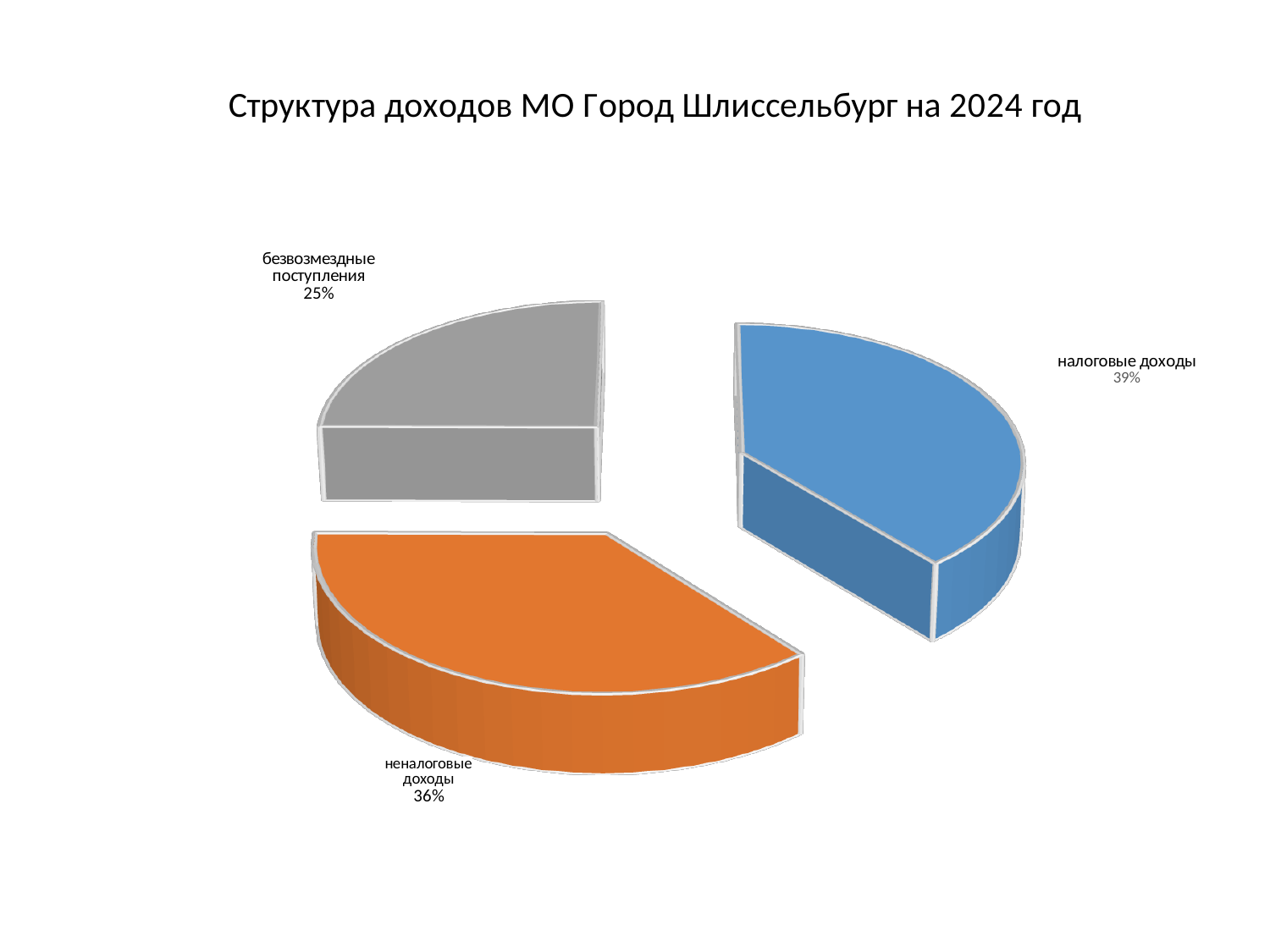
Which category has the largest share of the pie? налоговые доходы What is the difference in percentage points between налоговые доходы and неналоговые доходы? 3% Which is larger: the share for неналоговые доходы or the share for безвозмездные поступления? неналоговые доходы What colour is the slice for налоговые доходы? blue What is the title of the chart? Структура доходов МО Город Шлиссельбург на 2024 год What kind of chart is shown on the slide? pie chart What share of the pie does безвозмездные поступления represent? 25% What share of the pie does неналоговые доходы represent? 36% Which category has the smallest share of the pie? безвозмездные поступления How many categories are shown in the pie chart? 3 What share of the pie does налоговые доходы represent? 39% What is the difference in percentage points between неналоговые доходы and безвозмездные поступления? 11%